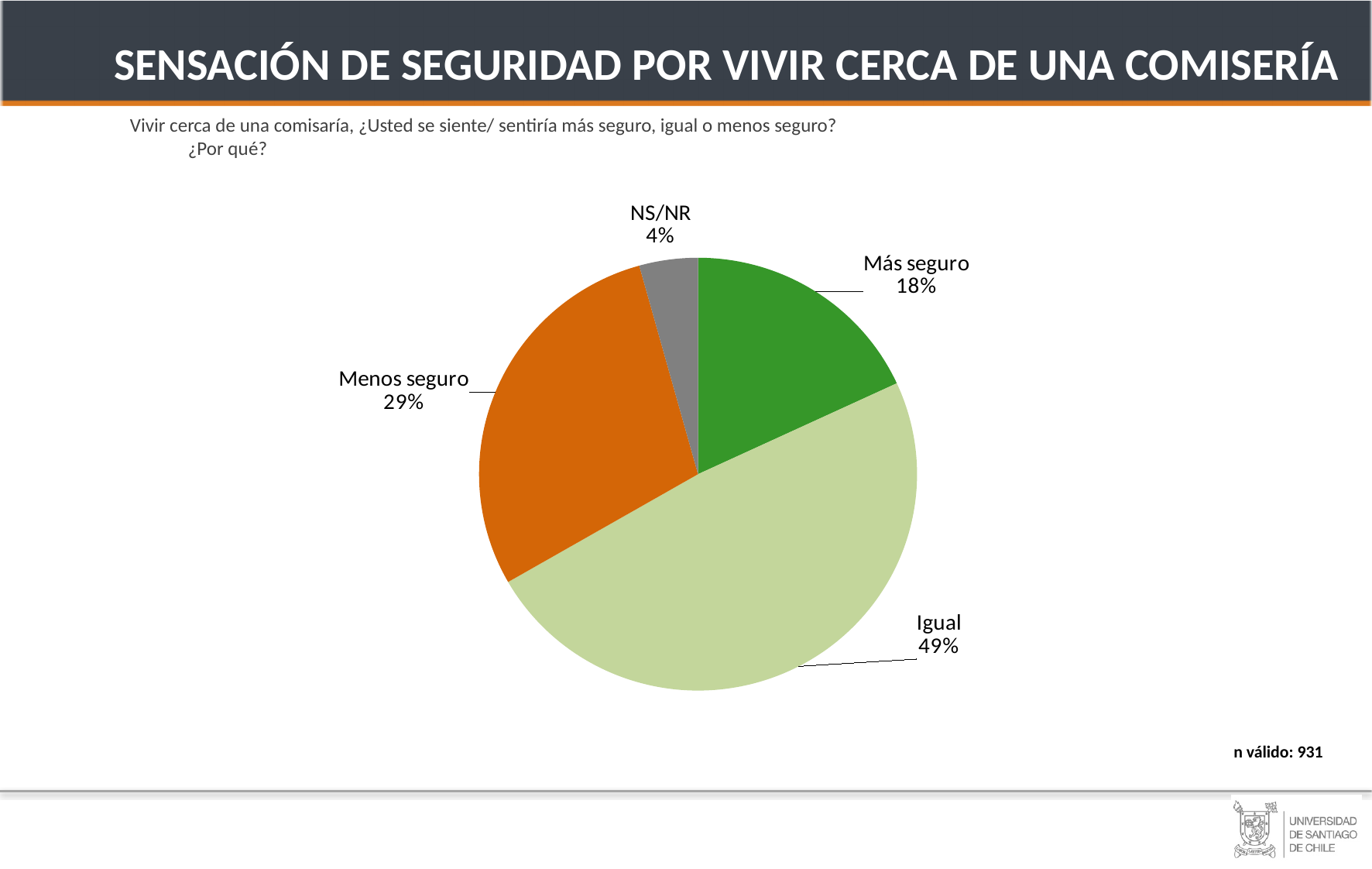
How many slices does the pie chart have? 4 What kind of chart is shown on the slide? pie chart Which is larger, the share for "Menos seguro" or the share for "Más seguro"? Menos seguro What percentage is shown for "NS/NR"? 4% What is the combined percentage of "Más seguro" and "Menos seguro"? 47% What percentage of respondents answered "Igual"? 49% What is the difference in percentage points between "Igual" and "Menos seguro"? 20 What percentage of respondents answered "Más seguro"? 18% Which category has the smallest share of the pie? NS/NR What is the valid sample size (n válido) shown on the slide? 931 Which category has the largest share of the pie? Igual What percentage of respondents answered "Menos seguro"? 29%